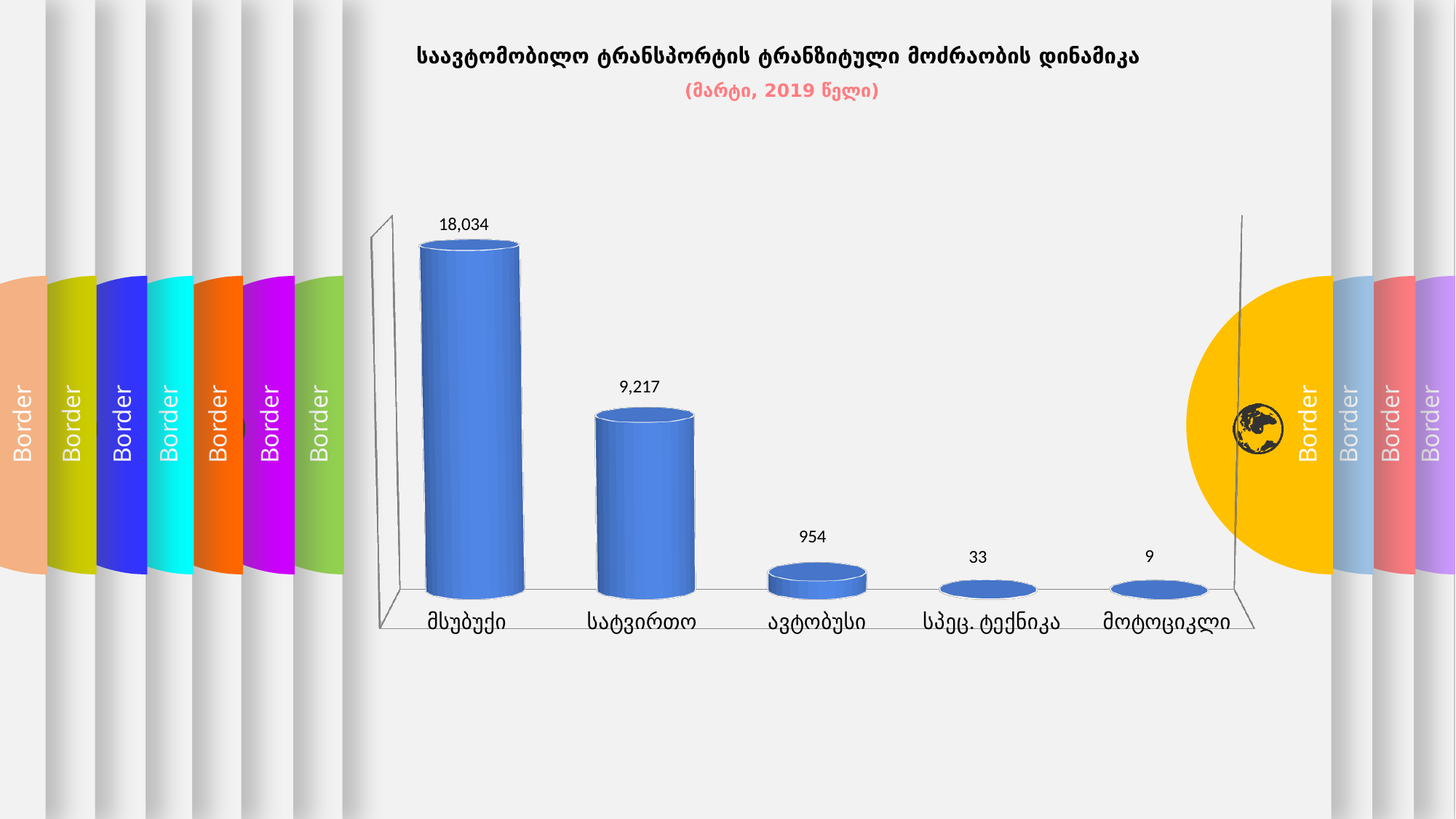
What is the value for სპეც. ტექნიკა? 33 What is the difference between the values for მსუბუქი and სატვირთო? 8,817 Which category has the lowest value? მოტოციკლი Which category has the highest value? მსუბუქი What is the value for სატვირთო? 9,217 What period is given in the chart's subtitle? მარტი, 2019 წელი What is the value for ავტობუსი? 954 What is the value for მოტოციკლი? 9 How many categories are shown on the chart? 5 Which is larger, the value for ავტობუსი or the value for სპეც. ტექნიკა? ავტობუსი What kind of chart is shown on the slide? Bar chart What is the value for მსუბუქი? 18,034